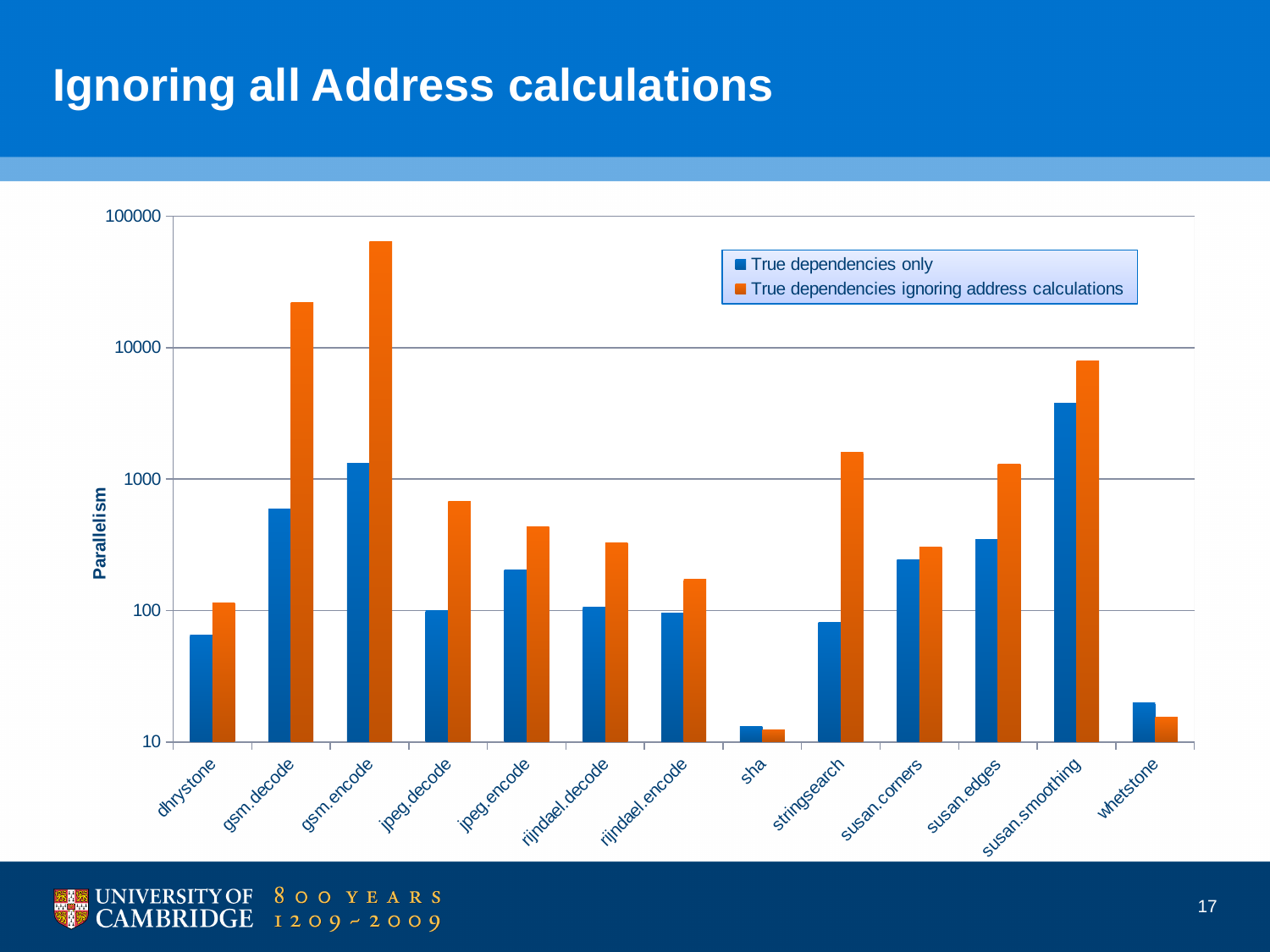
For whetstone, which series has the larger value: 'True dependencies only' or 'True dependencies ignoring address calculations'? True dependencies only How many benchmark categories are shown on the x axis? 13 Is the 'True dependencies ignoring address calculations' value for gsm.encode greater or less than 10000? greater What is the label of the y axis? Parallelism How many series does the legend list? 2 Is the 'True dependencies ignoring address calculations' value for stringsearch greater or less than 1000? greater Which category has the lowest value for the 'True dependencies ignoring address calculations' series? sha Which category has the highest value for the 'True dependencies only' series? susan.smoothing Which category has the highest value for the 'True dependencies ignoring address calculations' series? gsm.encode Is the 'True dependencies ignoring address calculations' value for susan.smoothing greater or less than 10000? less What kind of chart is shown on the slide? bar chart